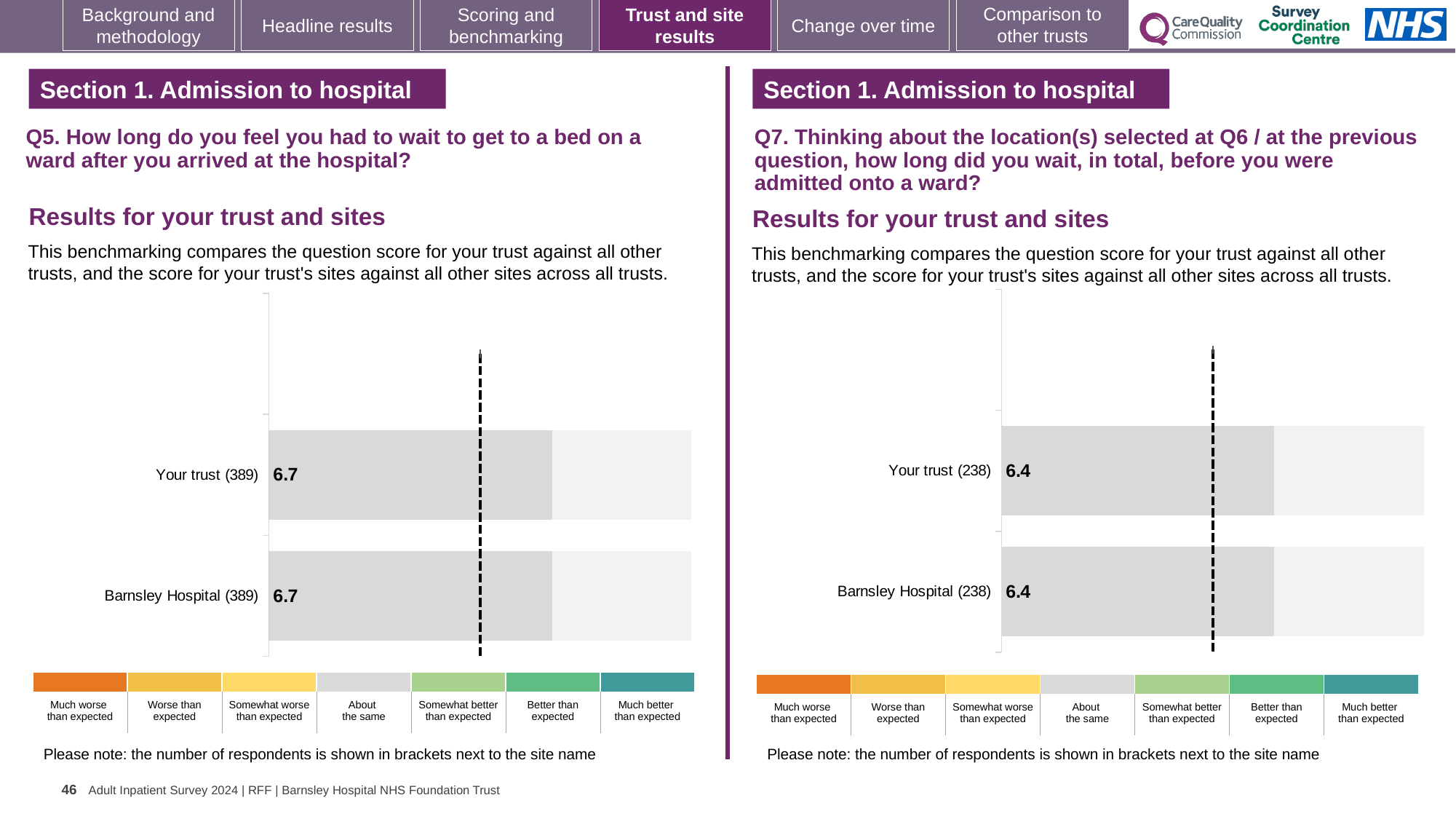
In the Q7 chart on the right, what is the score for Your trust? 6.4 In the Q7 chart on the right, how many respondents are shown in brackets for Barnsley Hospital? 238 How many categories does the colour key below the Q5 chart on the left list? 7 In the Q7 chart on the right, what is the score for Barnsley Hospital? 6.4 In the Q5 chart on the left, how many respondents are shown in brackets for Your trust? 389 Which is larger: the Your trust score in the Q5 chart on the left or the Your trust score in the Q7 chart on the right? Q5 chart on the left What kind of chart is the Q5 chart on the left? Bar chart How many bars are plotted in the Q7 chart on the right? 2 In the Q5 chart on the left, what is the score for Barnsley Hospital? 6.7 In the Q7 chart on the right, which category label is shown in the middle of the colour key below the chart? About the same In the Q5 chart on the left, what is the difference between the score for Your trust and the score for Barnsley Hospital? 0 In the Q5 chart on the left, what is the score for Your trust? 6.7